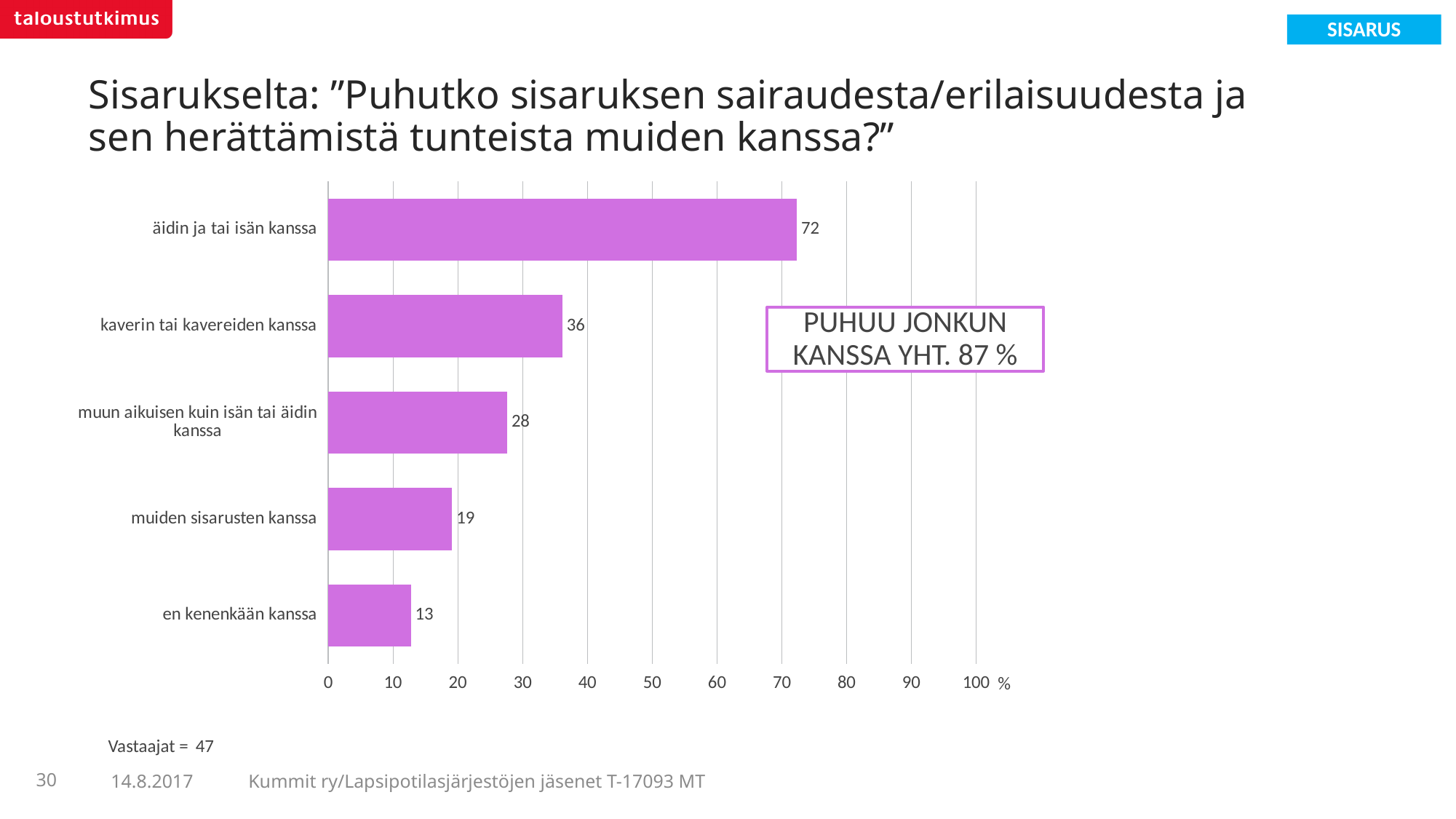
How many categories are shown in the chart? 5 What is the value for "äidin ja tai isän kanssa"? 72 What is the difference between the values for "äidin ja tai isän kanssa" and "kaverin tai kavereiden kanssa"? 36 What kind of chart is shown on the slide? bar chart Which category has the lowest value? en kenenkään kanssa What is the value for "kaverin tai kavereiden kanssa"? 36 Which is larger: the value for "muiden sisarusten kanssa" or the value for "muun aikuisen kuin isän tai äidin kanssa"? muun aikuisen kuin isän tai äidin kanssa What percentage does the text box on the chart say talk with someone in total? 87 % Which category has the highest value? äidin ja tai isän kanssa What is the value for "en kenenkään kanssa"? 13 Is the value for "muiden sisarusten kanssa" greater or less than 20? less What is the value for "muun aikuisen kuin isän tai äidin kanssa"? 28